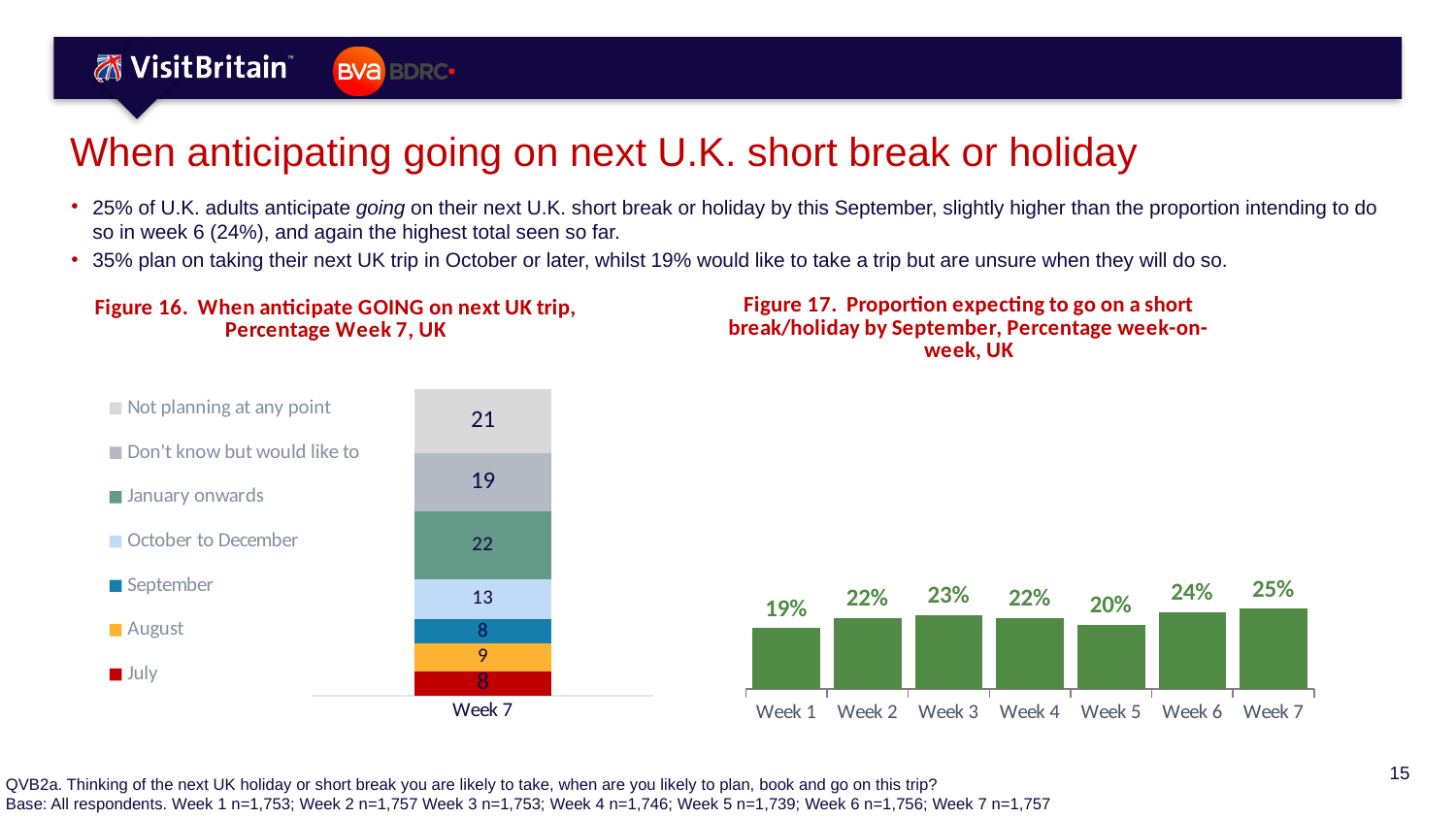
In Figure 17, which is larger, the value for Week 5 or the value for Week 6? Week 6 In Figure 16, how many series does the legend list? 7 In Figure 17, how many weeks are plotted? 7 In Figure 16, what is the value for the 'January onwards' segment? 22 What kind of chart is Figure 16? stacked bar chart In Figure 17, what is the value for Week 3? 23% In Figure 17, do the values rise or fall from Week 5 to Week 7? rise In Figure 17, which week has the highest proportion expecting to go on a short break/holiday by September? Week 7 In Figure 16, what is the total of the Week 7 stacked bar? 100 In Figure 16, what is the value for the 'Not planning at any point' segment? 21 In Figure 17, which week has the lowest value? Week 1 In Figure 17, what is the difference between the Week 7 value and the Week 1 value? 6%